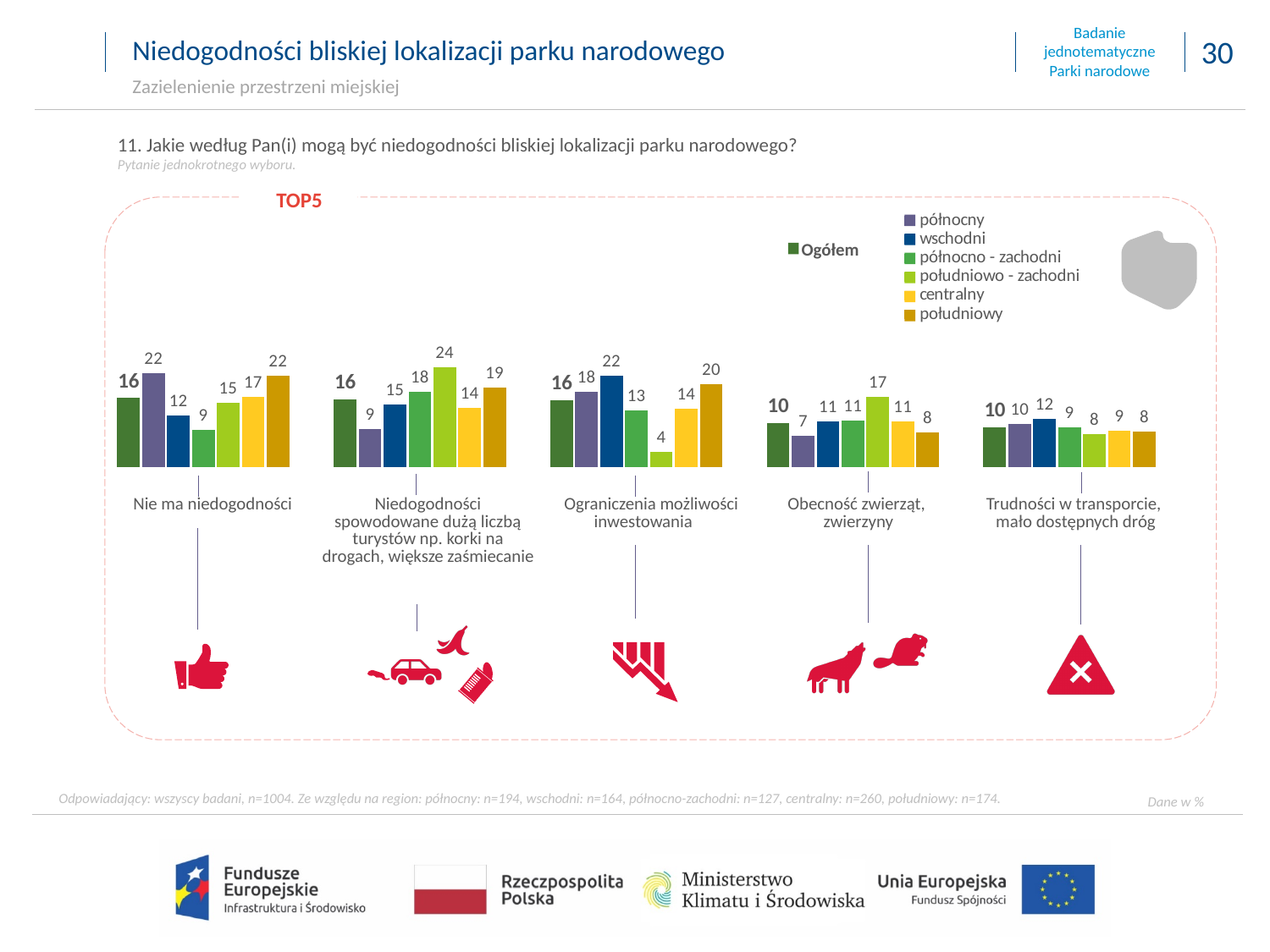
Which region has the highest value in the category 'Obecność zwierząt, zwierzyny'? południowo - zachodni What is the difference between the wschodni and północny values in the category 'Ograniczenia możliwości inwestowania'? 4 What type of chart is shown on the slide? bar chart How many categories are shown on the x axis of the chart? 5 What is the Ogółem value for 'Trudności w transporcie, mało dostępnych dróg'? 10 How many series does the legend list in total? 7 What is the value for the południowo - zachodni region in the category 'Niedogodności spowodowane dużą liczbą turystów np. korki na drogach, większe zaśmiecanie'? 24 Which region has the lowest value in the category 'Nie ma niedogodności'? północno - zachodni What is the value for the południowo - zachodni region in the category 'Ograniczenia możliwości inwestowania'? 4 What is the value for the centralny region in the category 'Nie ma niedogodności'? 17 What is the Ogółem value for 'Nie ma niedogodności'? 16 In the category 'Niedogodności spowodowane dużą liczbą turystów np. korki na drogach, większe zaśmiecanie', which is larger: the północny value or the południowy value? południowy